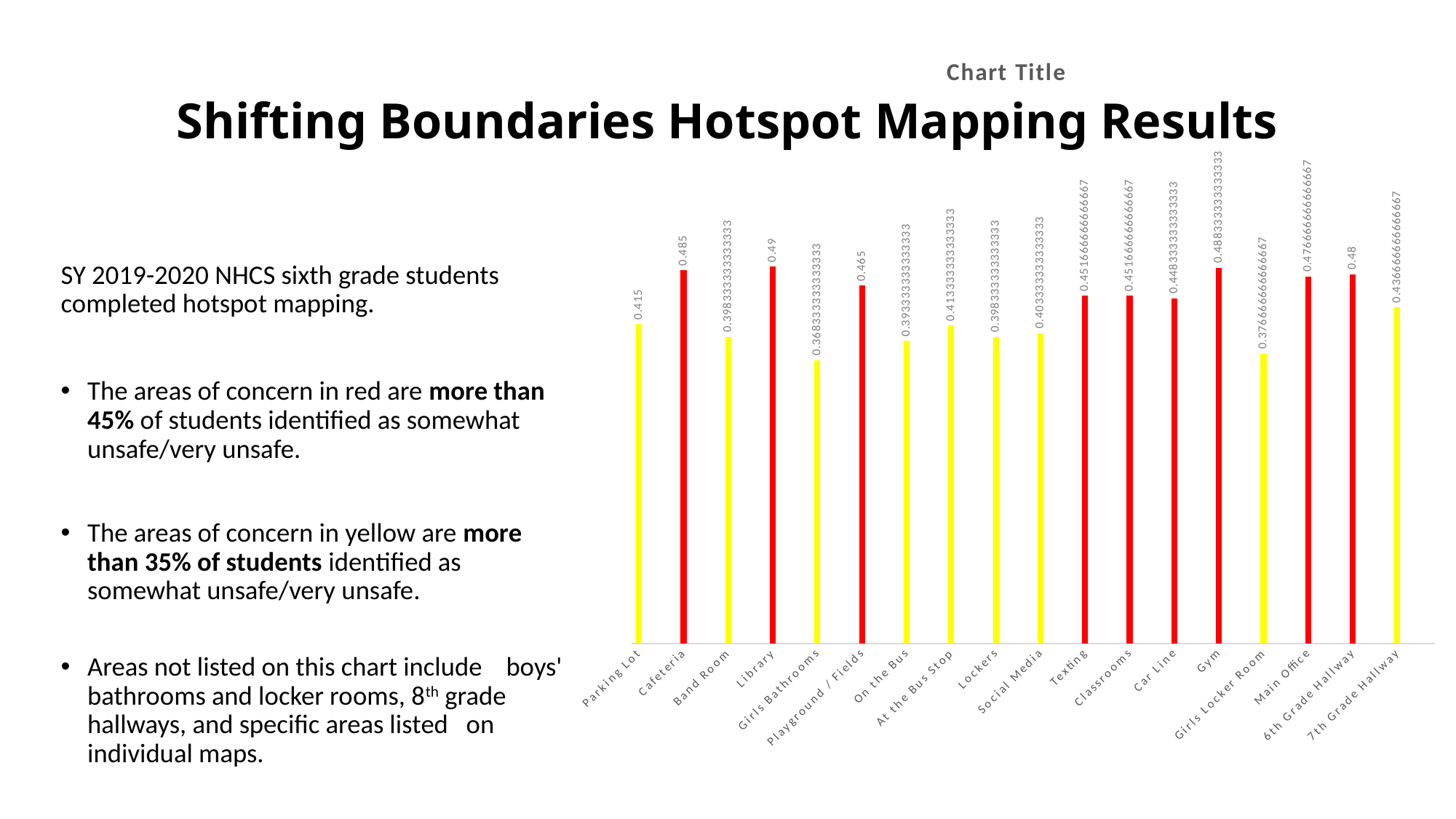
What kind of chart is shown on the slide? Bar chart What is the value for Cafeteria? 0.485 What is the value for Parking Lot? 0.415 How many categories are shown on the chart? 18 How many bars on the chart are red? 9 What is the value for Library? 0.49 Which is larger, the value for Cafeteria or the value for Playground / Fields? Cafeteria What is the difference between the values for Library and Cafeteria? 0.005 Which category has the lowest value? Girls Bathrooms Which category has the highest value? Library What is the difference between the values for 6th Grade Hallway and Parking Lot? 0.065 What is the value for 6th Grade Hallway? 0.48